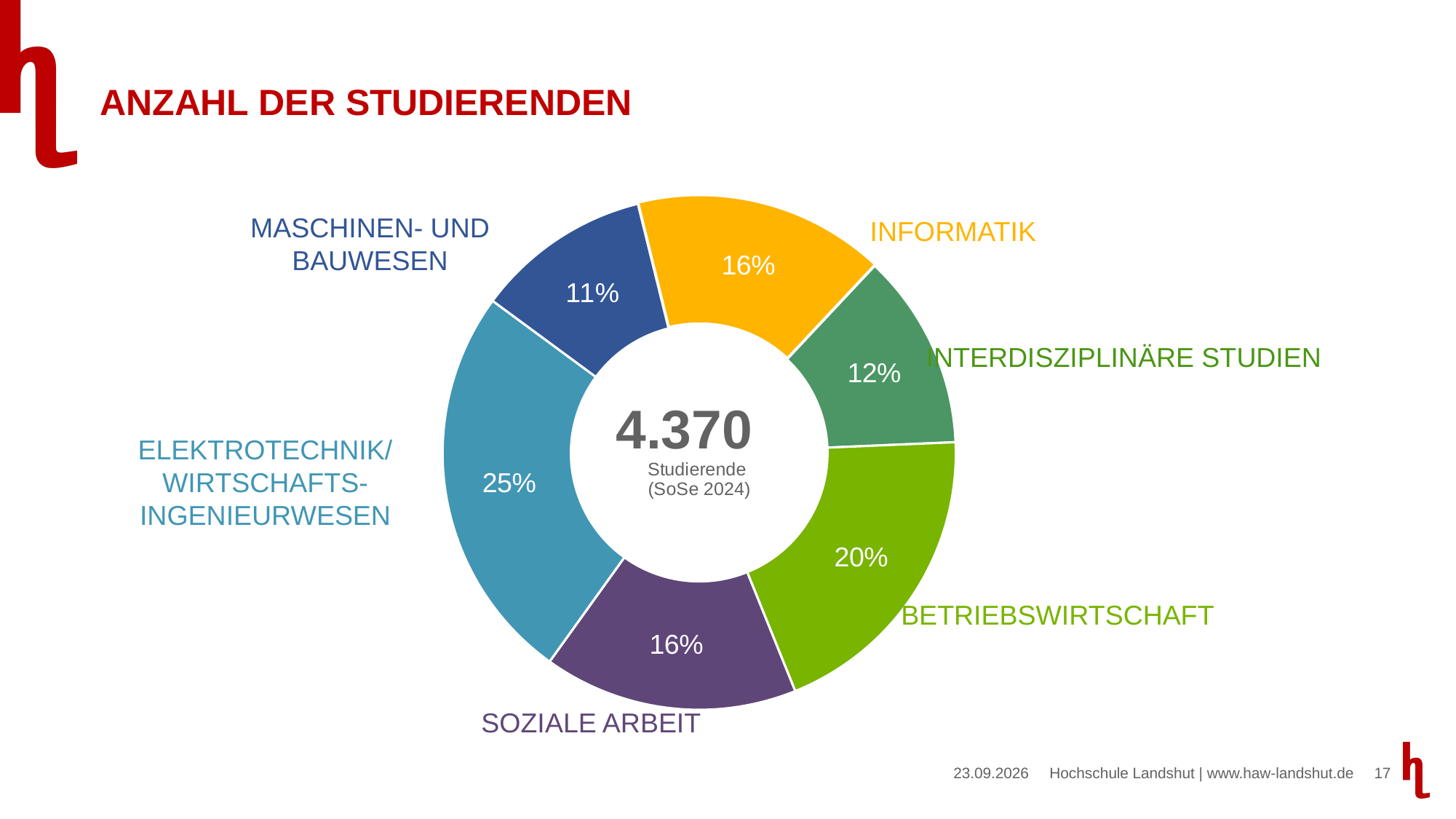
Which has a larger share, Betriebswirtschaft or Interdisziplinäre Studien? Betriebswirtschaft What share of students is in Interdisziplinäre Studien? 12% Which faculty has the smallest share of students? Maschinen- und Bauwesen What share of students is in Informatik? 16% How many faculties are shown in the chart? 6 What share of students is in Elektrotechnik/Wirtschaftsingenieurwesen? 25% What is the difference in percentage points between Elektrotechnik/Wirtschaftsingenieurwesen and Soziale Arbeit? 9 What kind of chart is shown on the slide? Pie chart (donut) Which faculty has the largest share of students? Elektrotechnik/Wirtschaftsingenieurwesen What total number of students is shown in the centre of the chart? 4.370 What share of students is in Betriebswirtschaft? 20% What share of students is in Maschinen- und Bauwesen? 11%